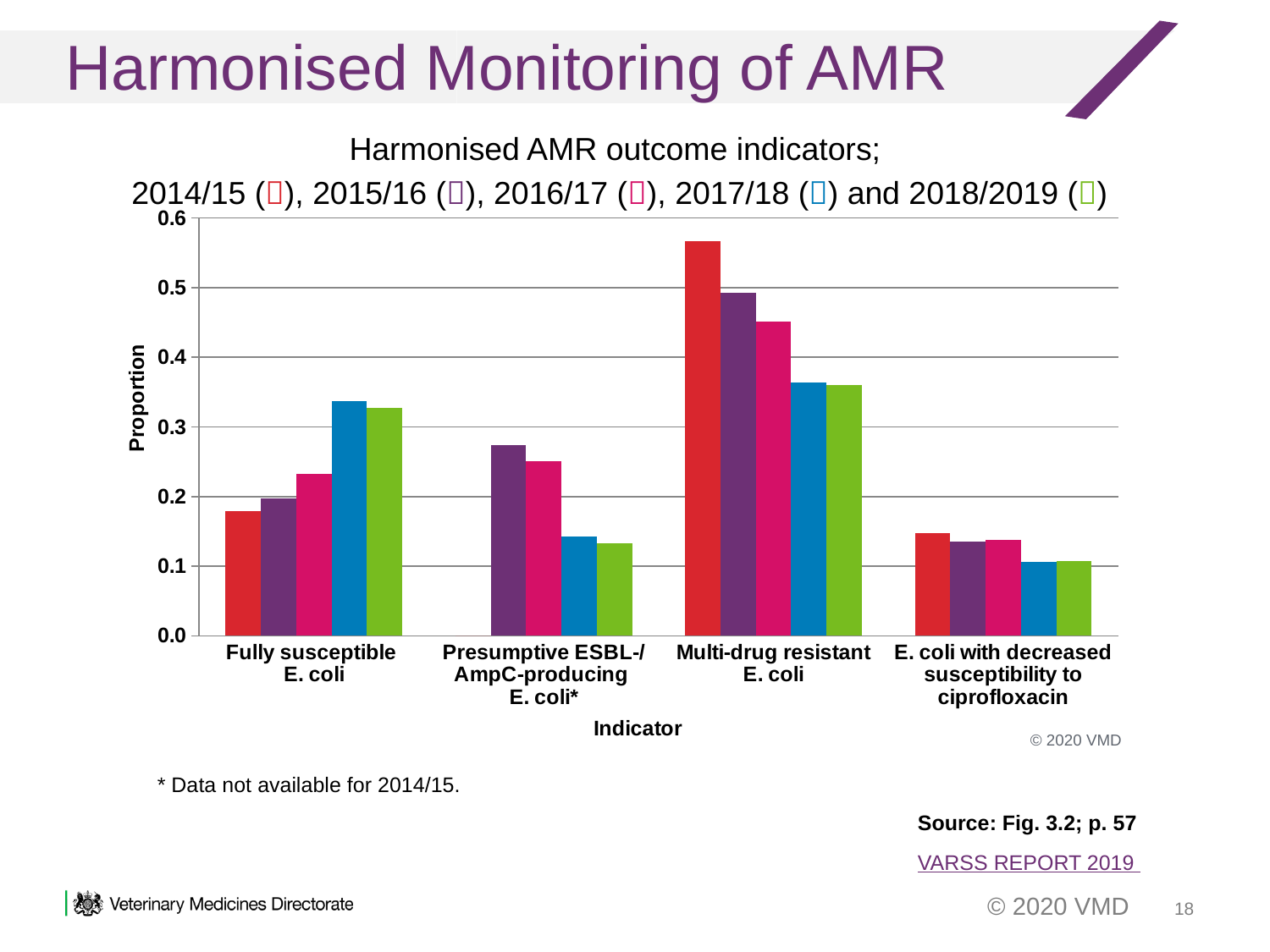
Is the 2014/15 value for Multi-drug resistant E. coli greater or less than 0.5? greater Do the values for Multi-drug resistant E. coli rise or fall from 2014/15 to 2018/2019? fall How many indicators are shown along the x axis of the chart? 4 What type of chart is shown on the slide? Bar chart Is the 2018/2019 value for Presumptive ESBL-/AmpC-producing E. coli greater or less than 0.2? less Within the Multi-drug resistant E. coli group, which year has the highest proportion? 2014/15 Which indicator has no bar for 2014/15? Presumptive ESBL-/AmpC-producing E. coli* Do the values for Fully susceptible E. coli rise or fall from 2014/15 to 2018/2019? rise How many reporting years (series) does the chart's legend list? 5 Which indicator has the tallest bar in the chart? Multi-drug resistant E. coli Is the 2017/18 value for E. coli with decreased susceptibility to ciprofloxacin greater or less than 0.2? less